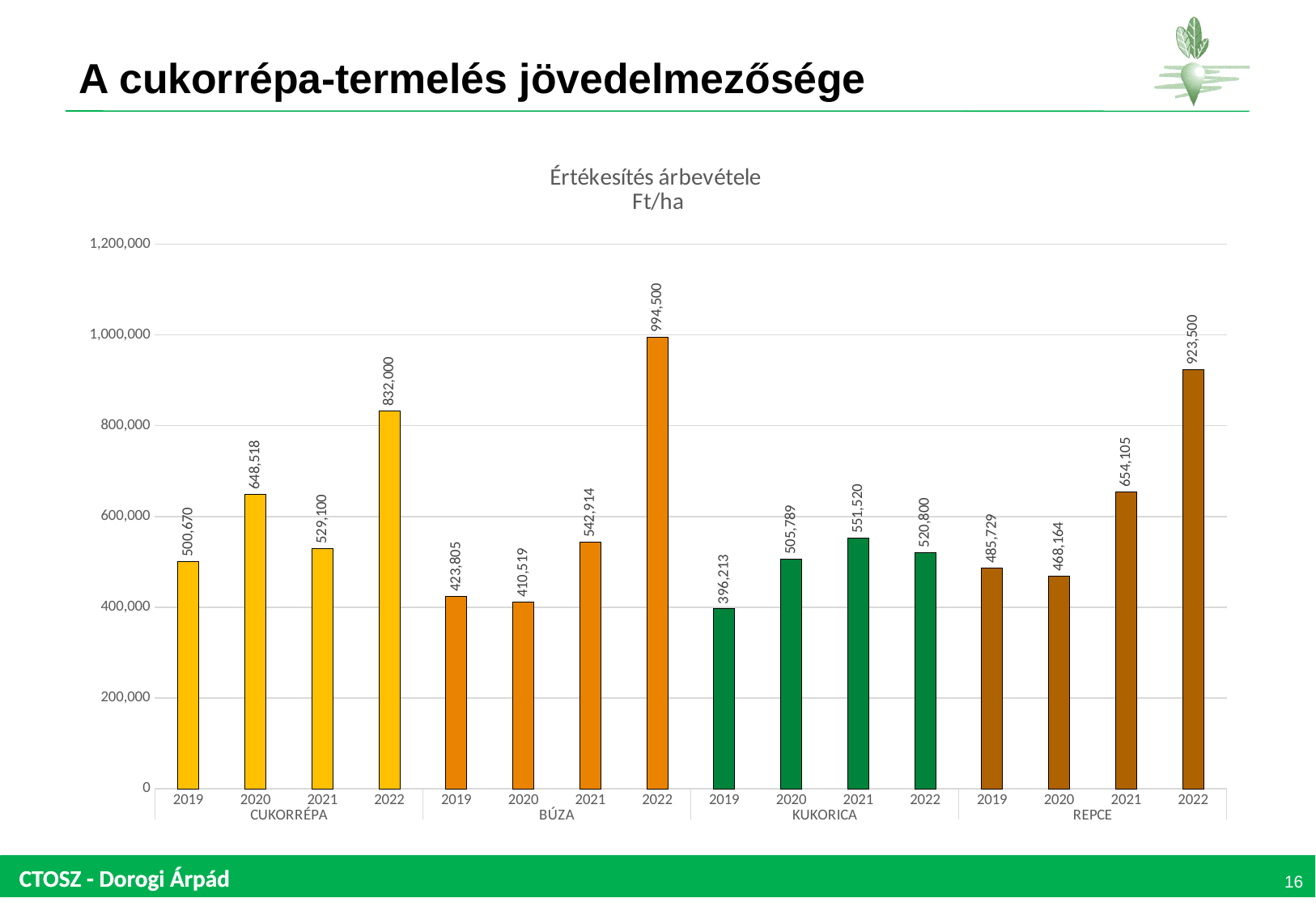
How many bars are plotted on the chart? 16 What is the value for REPCE in 2019? 485,729 Is the value for BÚZA in 2022 greater or less than 800,000? greater What kind of chart is shown on the slide? bar chart What is the difference between the CUKORRÉPA values for 2022 and 2019? 331,330 Which bar has the lowest value on the chart? KUKORICA 2019 Which is larger, the REPCE value for 2022 or the CUKORRÉPA value for 2022? REPCE 2022 What is the value for BÚZA in 2020? 410,519 What is the value for CUKORRÉPA in 2022? 832,000 Which bar has the highest value on the chart? BÚZA 2022 What is the value for KUKORICA in 2021? 551,520 What is the title of the chart? Értékesítés árbevétele Ft/ha